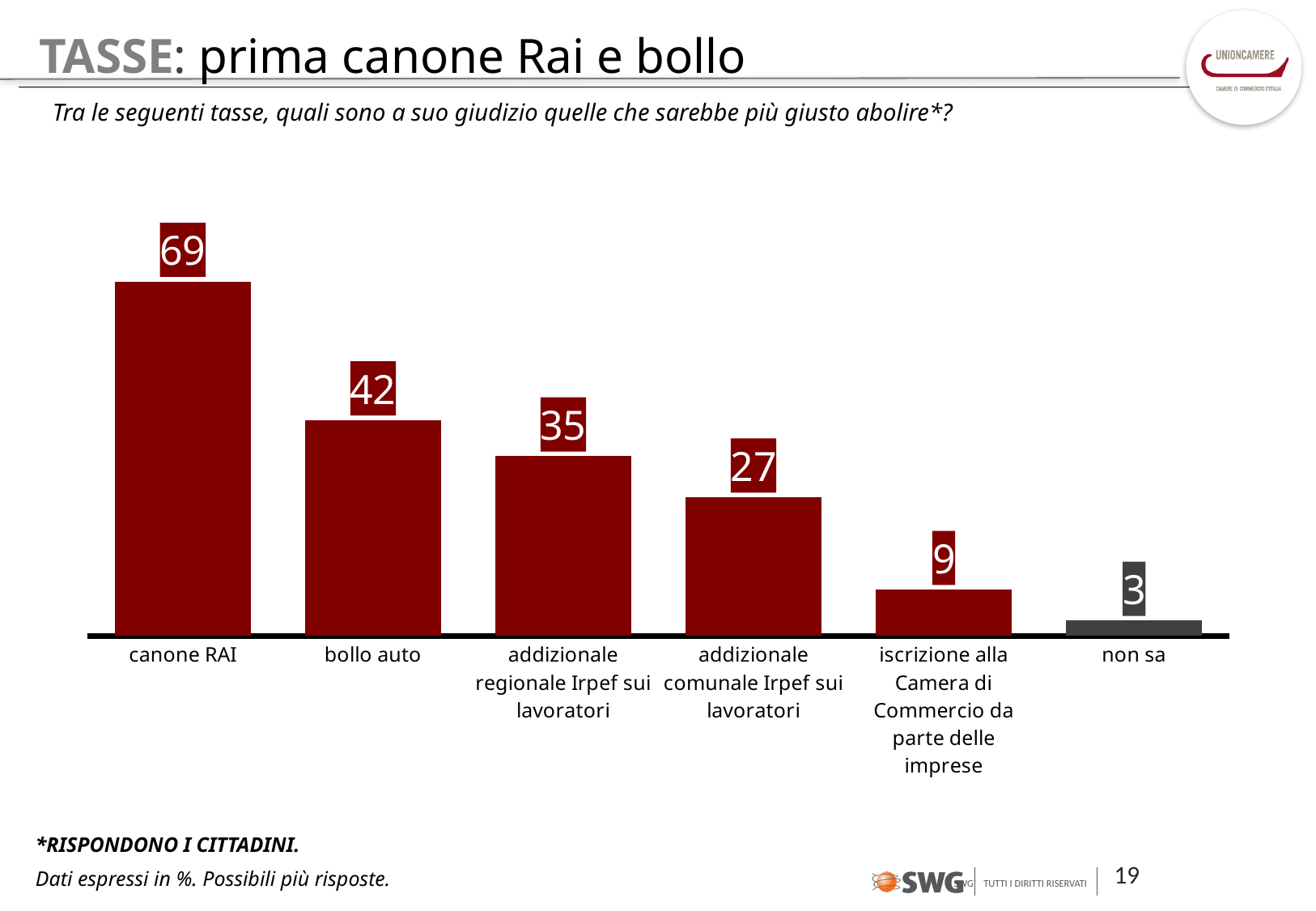
What kind of chart is shown on the slide? bar chart Do the values rise or fall from left to right across the categories? fall How many categories are shown in the chart? 6 What is the value for iscrizione alla Camera di Commercio da parte delle imprese? 9 Which is larger, the value for addizionale regionale Irpef sui lavoratori or addizionale comunale Irpef sui lavoratori? addizionale regionale Irpef sui lavoratori What is the value for non sa? 3 Which category has the highest value? canone RAI Which category has the lowest value? non sa What is the value for addizionale regionale Irpef sui lavoratori? 35 What is the difference between the values for canone RAI and bollo auto? 27 What is the value for canone RAI? 69 What is the value for bollo auto? 42